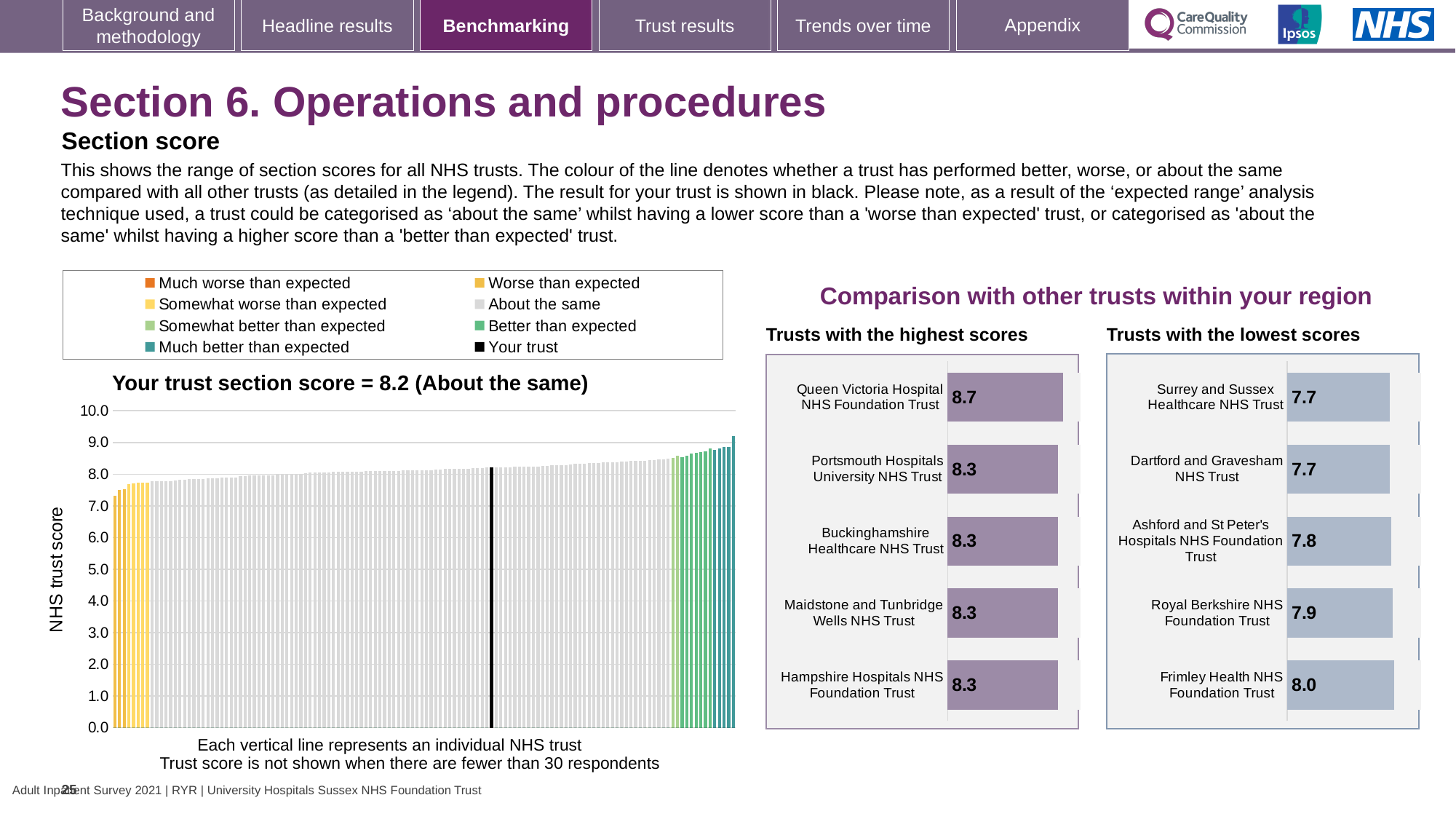
In the 'Trusts with the lowest scores' chart, which trust has the highest score? Frimley Health NHS Foundation Trust In the 'Trusts with the lowest scores' chart, which is larger: the score for Royal Berkshire NHS Foundation Trust or Ashford and St Peter's Hospitals NHS Foundation Trust? Royal Berkshire NHS Foundation Trust How many entries does the legend above the main chart on the left list? 8 In the 'Trusts with the highest scores' chart, what is the difference between the scores of Queen Victoria Hospital NHS Foundation Trust and Portsmouth Hospitals University NHS Trust? 0.4 In the 'Trusts with the highest scores' chart, what is the score for Queen Victoria Hospital NHS Foundation Trust? 8.7 In the 'Trusts with the lowest scores' chart, what is the score for Royal Berkshire NHS Foundation Trust? 7.9 In the main chart on the left, do the trust scores rise or fall from left to right along the x axis? Rise In the main chart on the left, what is your trust's section score? 8.2 What kind of chart is the main chart on the left showing the range of section scores? Bar chart In the 'Trusts with the highest scores' chart, which trust has the highest score? Queen Victoria Hospital NHS Foundation Trust How many trusts are shown in the 'Trusts with the highest scores' chart? 5 In the 'Trusts with the lowest scores' chart, what is the difference between the scores of Frimley Health NHS Foundation Trust and Surrey and Sussex Healthcare NHS Trust? 0.3